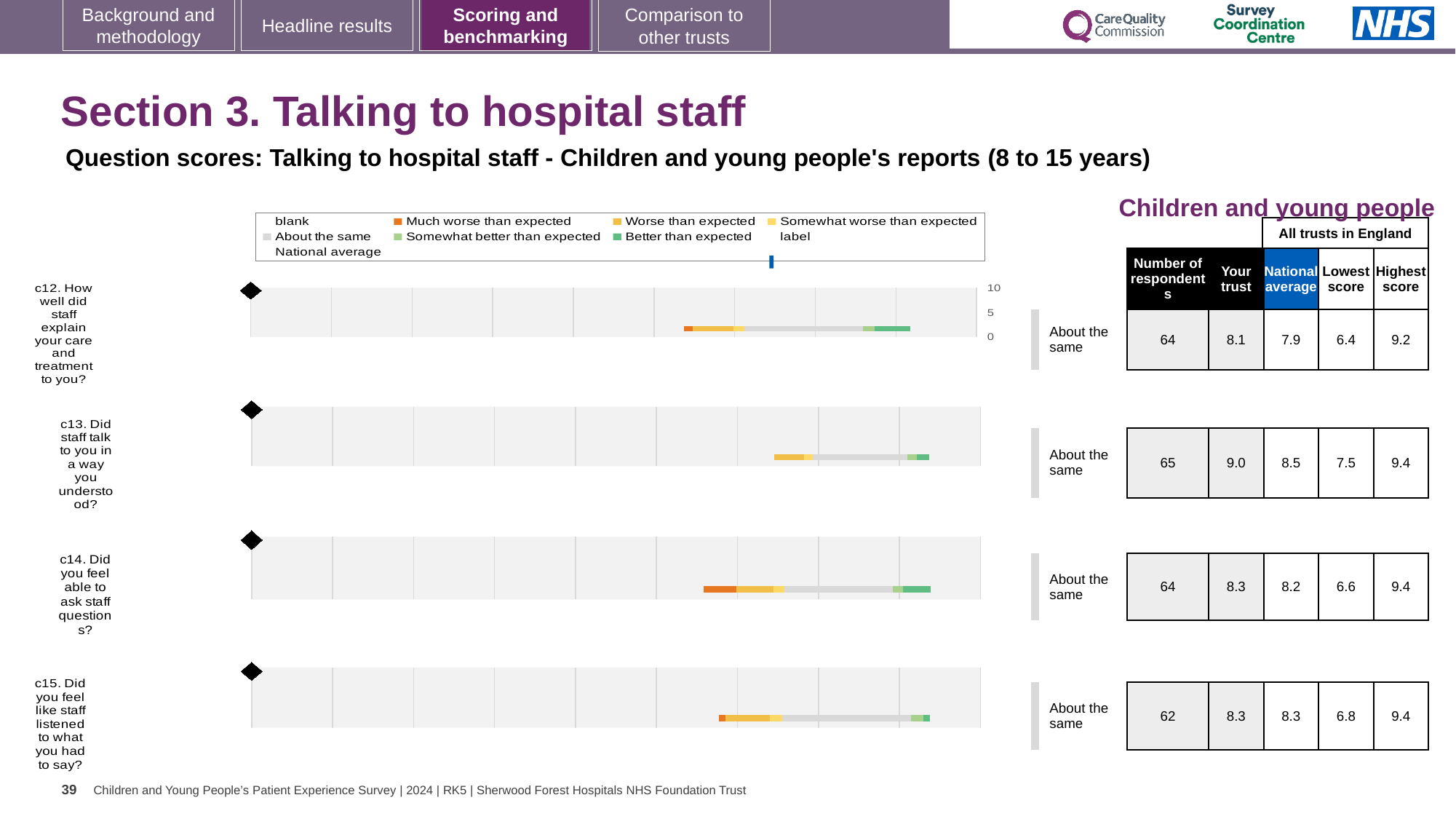
What is the 'Your trust' score for c13 (Did staff talk to you in a way you understood?)? 9.0 What is the national average score for c12 (How well did staff explain your care and treatment to you?)? 7.9 What colour represents 'Much worse than expected' in the legend? orange What is the lowest score among all trusts in England for c14 (Did you feel able to ask staff questions?)? 6.6 How many questions (c12 to c15) are plotted on the slide? 4 For c14, which is larger: the 'Your trust' score or the national average? Your trust How many respondents answered c15 (Did you feel like staff listened to what you had to say?)? 62 Which question has the lowest national average score? c12 For c13, how much higher is the 'Your trust' score than the national average? 0.5 What kind of chart is used to show the question scores for c12 to c15? bar chart Which question has the highest 'Your trust' score? c13 What benchmark category is shown for c12? About the same